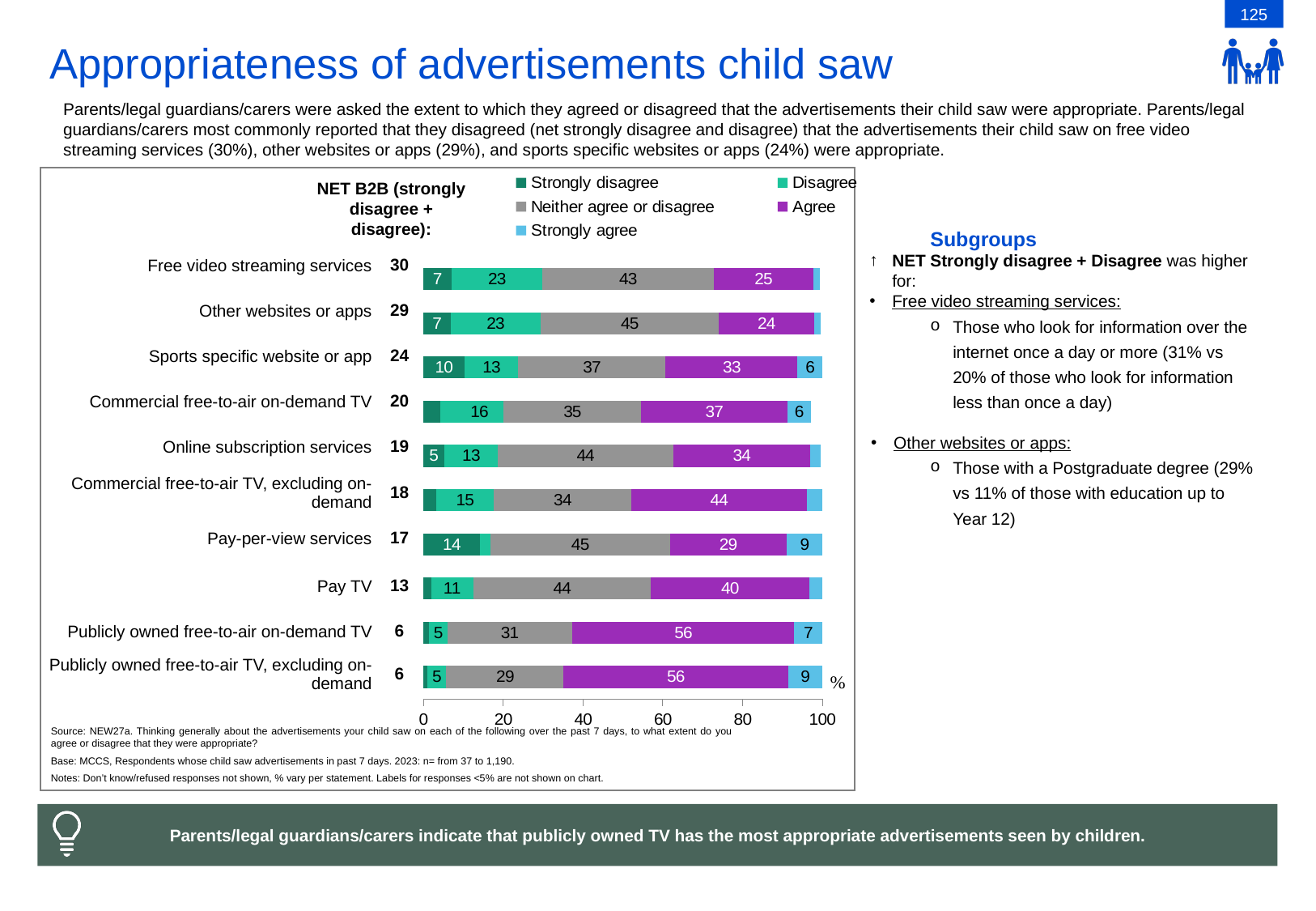
What is the Agree value for Free video streaming services? 25 Which has a larger Agree value: Commercial free-to-air TV, excluding on-demand or Online subscription services? Commercial free-to-air TV, excluding on-demand What is the Strongly disagree value for Sports specific website or app? 10 What is the NET B2B (strongly disagree + disagree) value for Commercial free-to-air on-demand TV? 20 What colour represents the Agree series in the chart? Purple What is the Neither agree or disagree value for Other websites or apps? 45 What kind of chart is shown on the slide? Stacked bar chart Which category has the lowest Neither agree or disagree value? Publicly owned free-to-air TV, excluding on-demand How many categories (services) are plotted in the chart? 10 How many series does the chart legend list? 5 Which category has the highest NET B2B (strongly disagree + disagree) value? Free video streaming services What is the difference between the Agree value for Pay TV and the Agree value for Pay-per-view services? 11